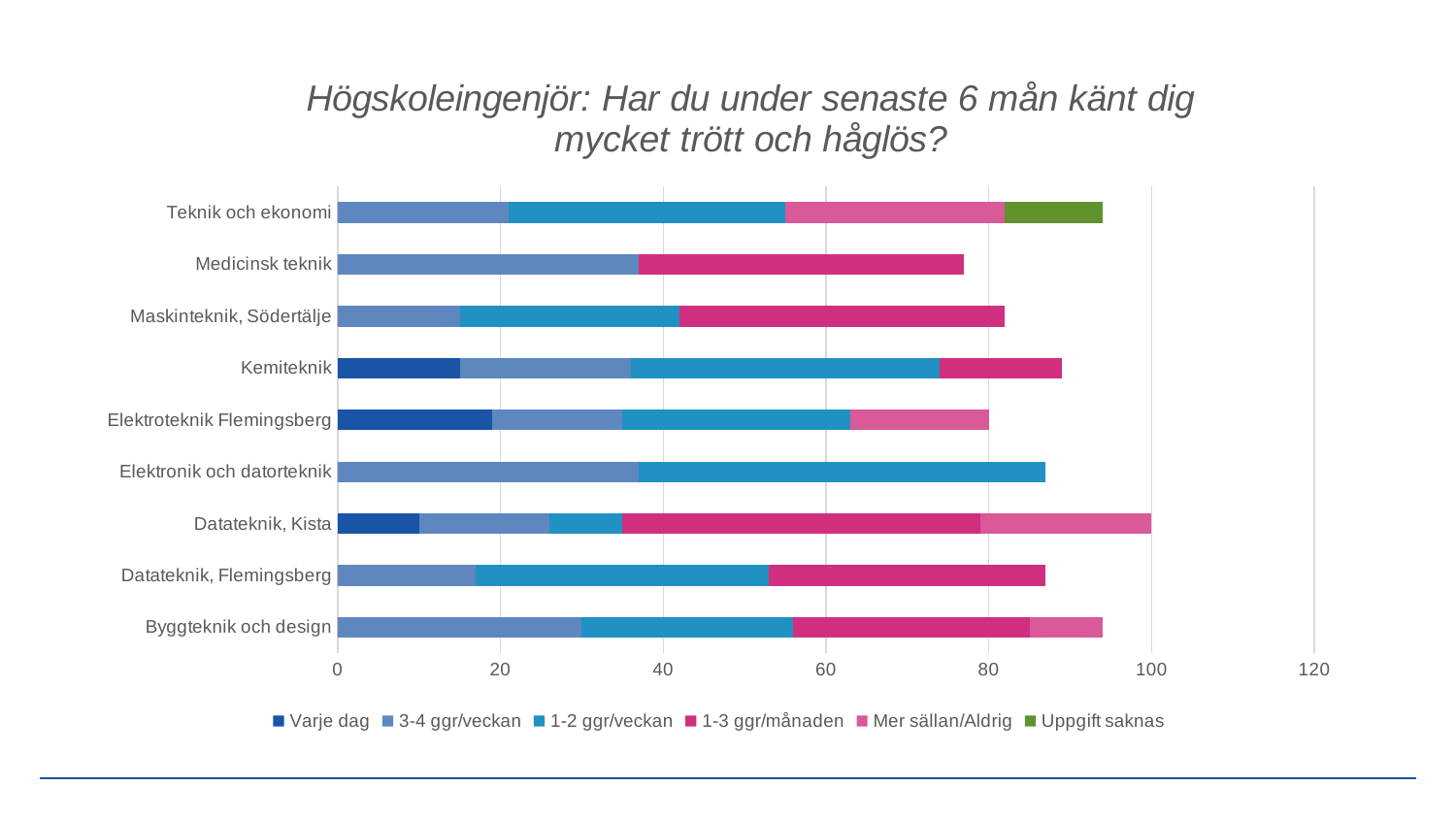
Which category is the only one with an 'Uppgift saknas' (green) segment? Teknik och ekonomi How many series does the legend list? 6 What is the first series listed in the legend? Varje dag Which category has the longest total bar? Datateknik, Kista Is the total bar length for Maskinteknik, Södertälje greater or less than 60? greater How many programme categories are listed on the vertical axis? 9 What kind of chart is shown on the slide? Stacked bar chart Which has the longer total bar, Datateknik, Kista or Medicinsk teknik? Datateknik, Kista Is the total bar length for Datateknik, Kista greater or less than 80? greater Is the total bar length for Kemiteknik greater or less than 80? greater Which has the longer total bar, Teknik och ekonomi or Elektroteknik Flemingsberg? Teknik och ekonomi